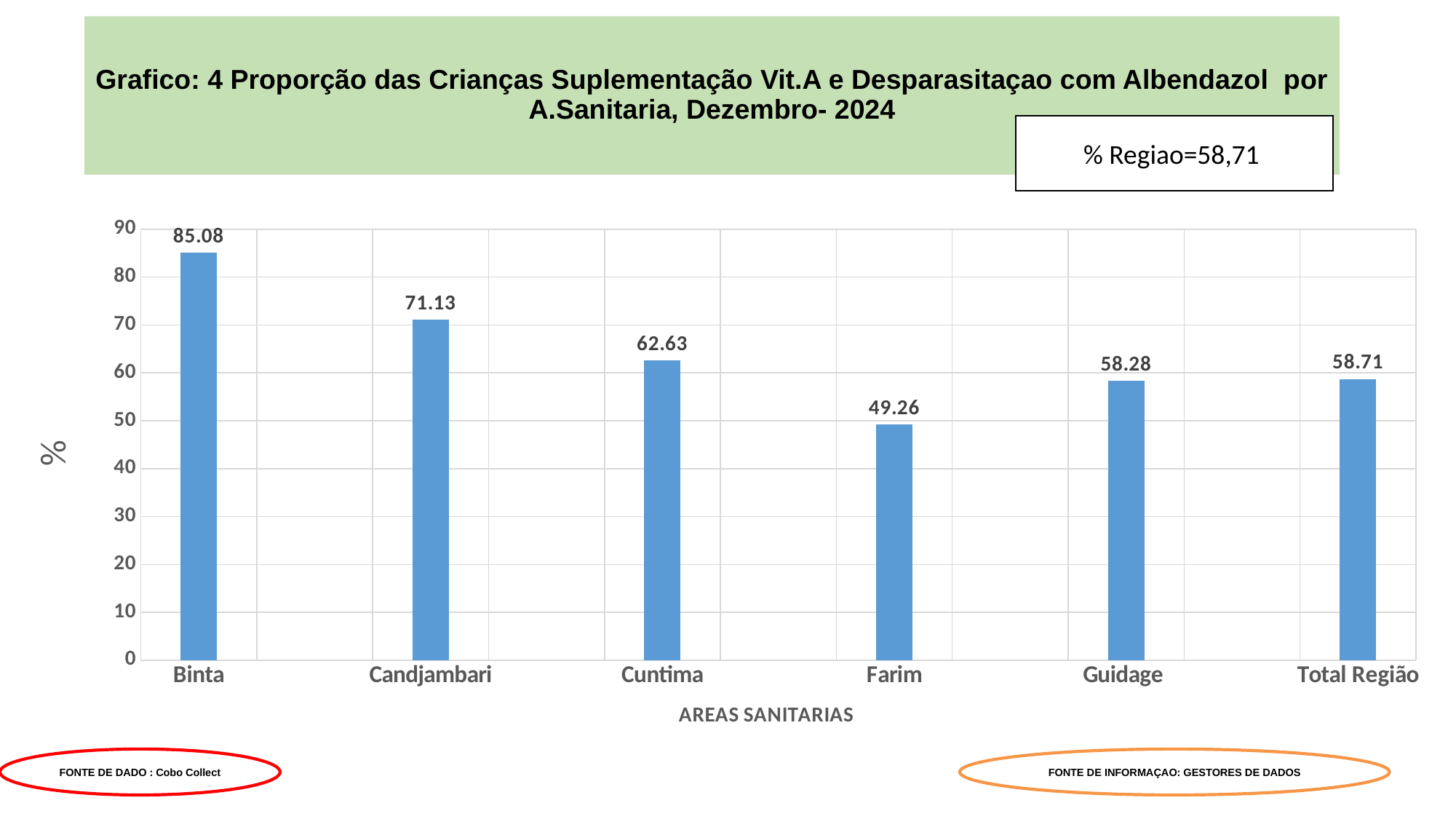
Which area has the lowest value? Farim What is the difference between the values for Cuntima and Farim? 13.37 What is the value for Farim? 49.26 Which area has the highest value? Binta What is the difference between the values for Binta and Candjambari? 13.95 What is the value for Binta? 85.08 What is the value for Total Região? 58.71 What is the x-axis title of the chart? AREAS SANITARIAS Which is larger, the value for Cuntima or the value for Guidage? Cuntima Is the value for Farim greater or less than 50? less What kind of chart is shown on the slide? bar chart How many categories are shown on the x axis? 6